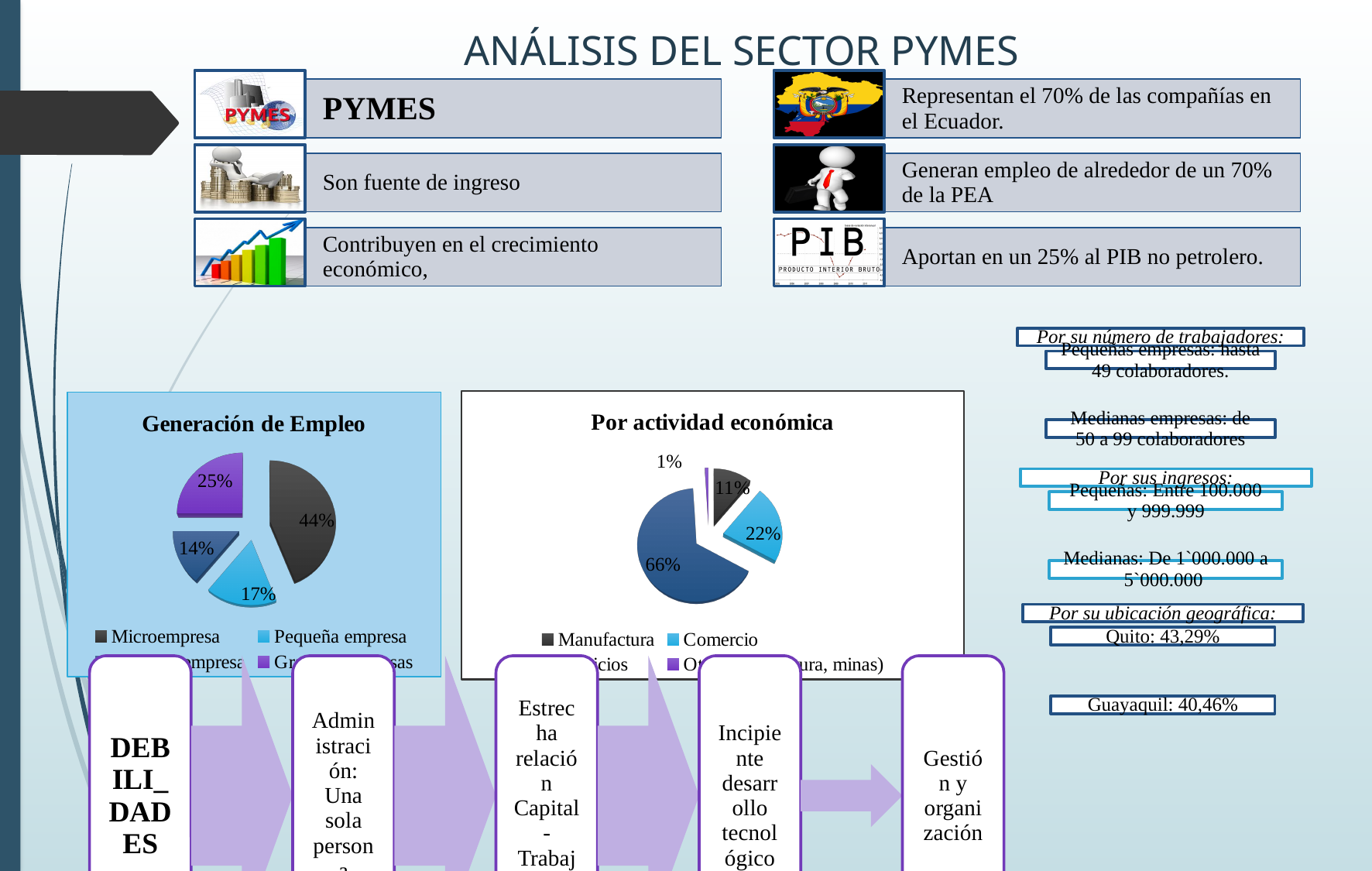
In the "Generación de Empleo" chart, what percentage is shown for Pequeña empresa? 17% In the "Por actividad económica" chart, what percentage is shown for Manufactura? 11% How many slices does the "Generación de Empleo" pie chart have? 4 In the "Por actividad económica" chart, what percentage is shown for Comercio? 22% What kind of chart is the "Generación de Empleo" chart? Pie chart In the "Generación de Empleo" chart, which category has the largest slice? Microempresa In the "Generación de Empleo" chart, what is the difference in percentage points between Microempresa and Pequeña empresa? 27 percentage points In the "Por actividad económica" chart, what is the largest percentage shown on any slice? 66% In the "Por actividad económica" chart, which is larger, Manufactura or Comercio? Comercio In the "Por actividad económica" chart, what is the difference in percentage points between Comercio and Manufactura? 11 percentage points In the "Generación de Empleo" chart, what is the smallest percentage shown on any slice? 14% In the "Generación de Empleo" chart, what percentage is shown for Microempresa? 44%